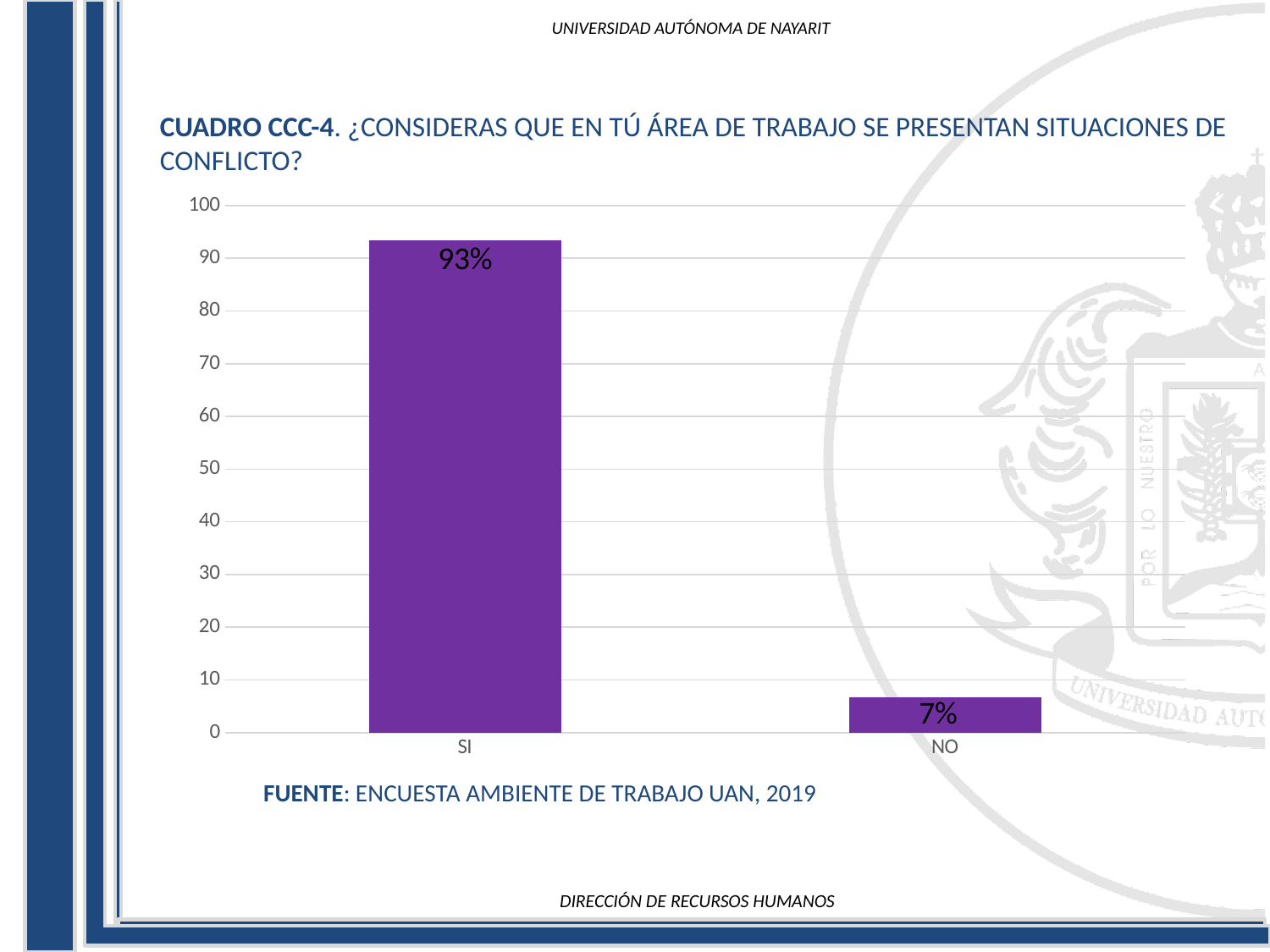
What colour are the bars in the chart? purple What is the value for NO? 7% How many categories are shown on the x axis? 2 What is the value for SI? 93% What kind of chart is shown on the slide? bar chart Which is larger, the value for SI or the value for NO? SI Is the value for SI greater or less than 90? greater Is the value for NO greater or less than 10? less What is the difference between the values for SI and NO? 86% Which category has the highest value? SI What is the source cited below the chart? ENCUESTA AMBIENTE DE TRABAJO UAN, 2019 Which category has the lowest value? NO